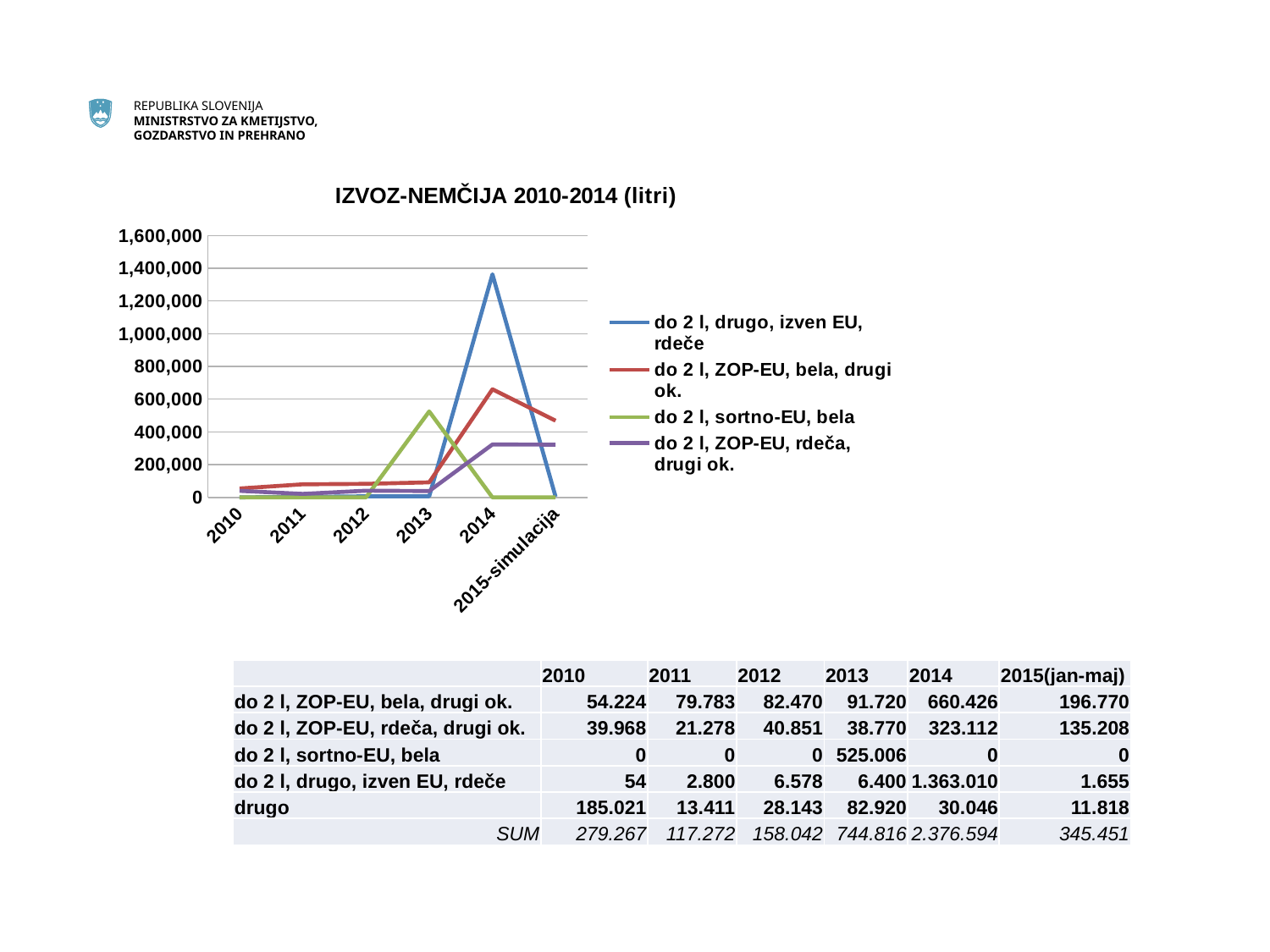
How many categories are shown on the x axis of the chart? 6 What is the title of the chart? IZVOZ-NEMČIJA 2010-2014 (litri) Is the value for do 2 l, drugo, izven EU, rdeče in 2014 greater or less than 1,200,000? greater How many series does the chart legend list? 4 What is the value for do 2 l, ZOP-EU, rdeča, drugi ok. in 2014? 323.112 What kind of chart is shown on the slide? line chart Does the value for do 2 l, ZOP-EU, bela, drugi ok. rise or fall from 2010 to 2014? rise What is the value for do 2 l, sortno-EU, bela in 2013? 525.006 What is the difference between do 2 l, ZOP-EU, bela, drugi ok. and do 2 l, ZOP-EU, rdeča, drugi ok. in 2014? 337.314 In 2013, which is larger: do 2 l, sortno-EU, bela or do 2 l, ZOP-EU, bela, drugi ok.? do 2 l, sortno-EU, bela Is the value for do 2 l, ZOP-EU, bela, drugi ok. in 2014 greater or less than 800,000? less Which series has the highest value in 2014? do 2 l, drugo, izven EU, rdeče